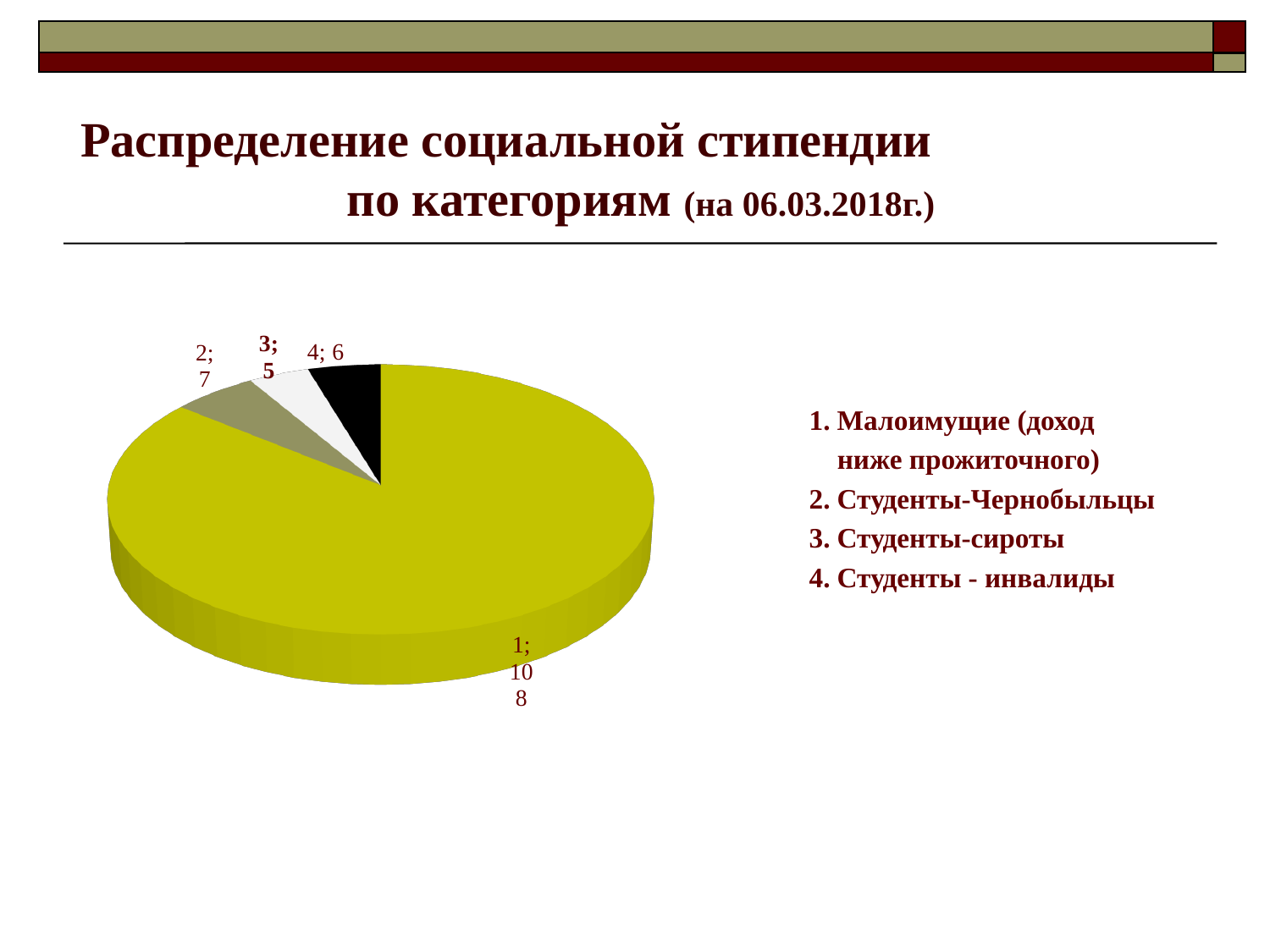
What is the value for category 2 (Студенты-Чернобыльцы) in the pie chart? 7 What is the value for category 1 (Малоимущие) in the pie chart? 108 Which category has the largest slice in the pie chart? 1 (Малоимущие) What colour is the slice for category 1 (Малоимущие)? yellow What is the value for category 3 (Студенты-сироты) in the pie chart? 5 Which is larger, the value for category 2 or the value for category 4? category 2 What is the difference between the values for category 1 and category 2? 101 How many slices does the pie chart have? 4 What is the total of all four values in the pie chart? 126 What is the value for category 4 (Студенты - инвалиды) in the pie chart? 6 What kind of chart is shown on the slide? pie chart Which category has the smallest slice in the pie chart? 3 (Студенты-сироты)